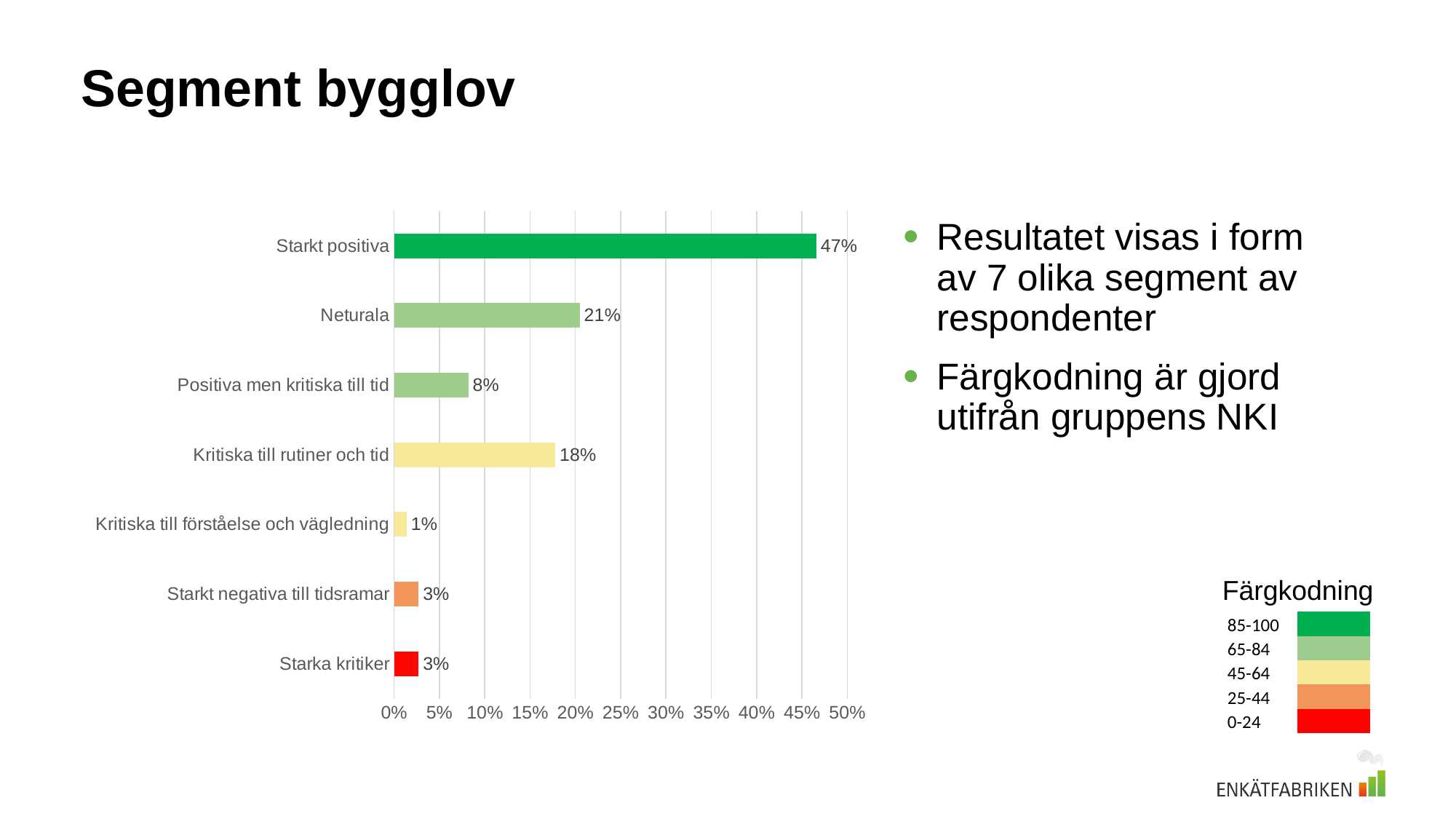
Which is larger, the value for Neturala or the value for Kritiska till rutiner och tid? Neturala What is the value for Positiva men kritiska till tid? 8% What is the value for Kritiska till rutiner och tid? 18% Is the value for Starkt positiva greater or less than 45%? greater What is the value for Neturala? 21% How many categories are shown in the chart? 7 Which category has the lowest value? Kritiska till förståelse och vägledning Which category has the highest value? Starkt positiva What colour is the bar for Starka kritiker? Red What kind of chart is shown on the slide? Bar chart What is the value for Starkt positiva? 47% What is the difference between the values for Starkt positiva and Neturala? 26%